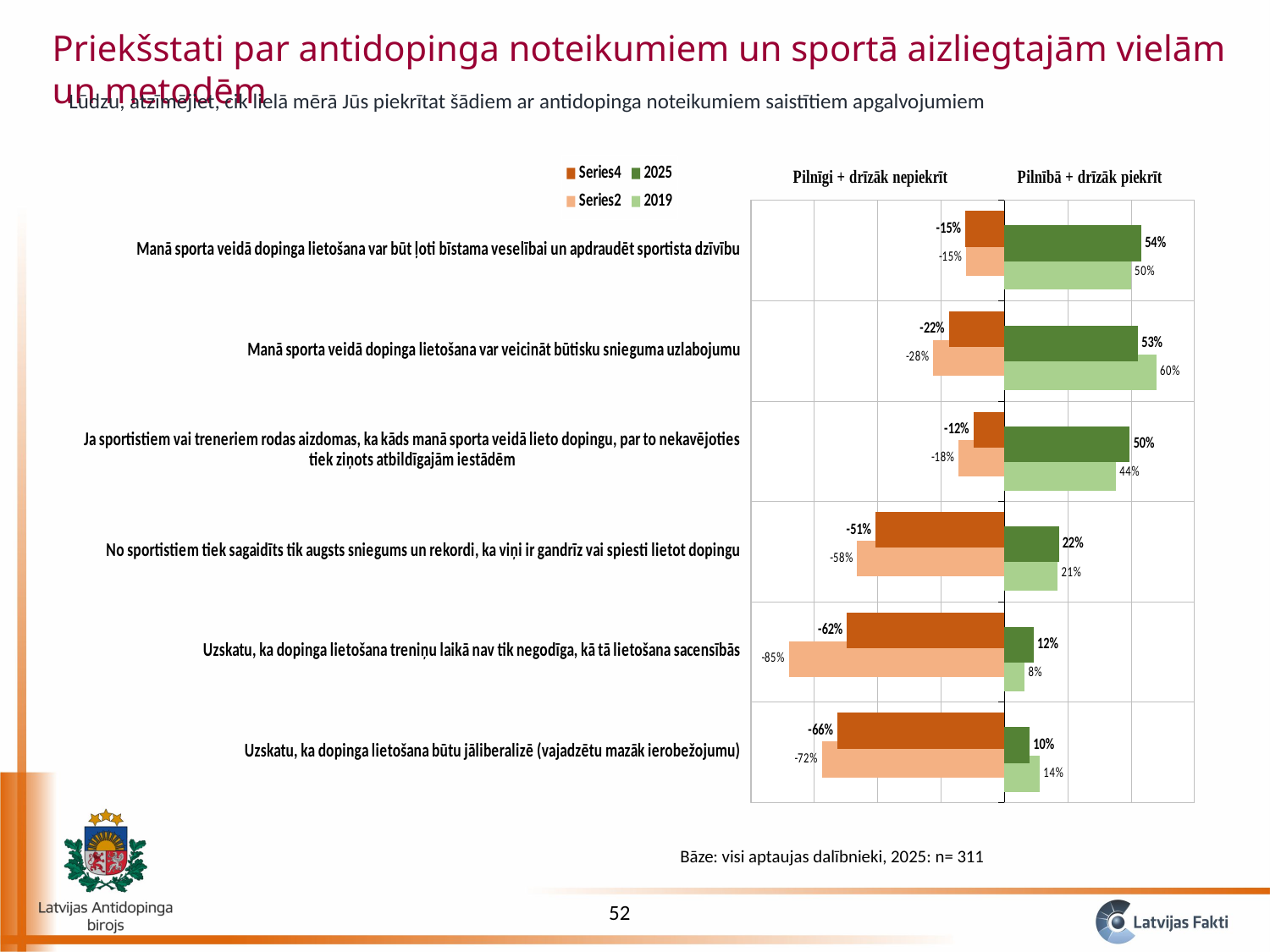
What kind of chart is shown on the slide? bar chart Which statement has the lowest 2025 agreement value? Uzskatu, ka dopinga lietošana būtu jāliberalizē (vajadzētu mazāk ierobežojumu) What is the heading shown above the right-hand (agreement) side of the chart? Pilnībā + drīzāk piekrīt What is the 2025 agreement value (Pilnībā + drīzāk piekrīt) for the statement "Manā sporta veidā dopinga lietošana var būt ļoti bīstama veselībai un apdraudēt sportista dzīvību"? 54% What is the 2025 agreement value for the statement "No sportistiem tiek sagaidīts tik augsts sniegums un rekordi, ka viņi ir gandrīz vai spiesti lietot dopingu"? 22% How many statements (categories) are plotted in the chart? 6 What is the 2019 disagreement value (Pilnīgi + drīzāk nepiekrīt) for the statement "Uzskatu, ka dopinga lietošana treniņu laikā nav tik negodīga, kā tā lietošana sacensībās"? -85% How many series does the chart legend list? 4 What is the difference between the 2019 and 2025 agreement values for the statement "Manā sporta veidā dopinga lietošana var veicināt būtisku snieguma uzlabojumu"? 7 percentage points Which statement has the highest 2025 agreement value? Manā sporta veidā dopinga lietošana var būt ļoti bīstama veselībai un apdraudēt sportista dzīvību For the statement "Ja sportistiem vai treneriem rodas aizdomas, ka kāds manā sporta veidā lieto dopingu, par to nekavējoties tiek ziņots atbildīgajām iestādēm", is the 2025 agreement value larger or smaller than the 2019 agreement value? larger What is the 2019 agreement value for the statement "Manā sporta veidā dopinga lietošana var veicināt būtisku snieguma uzlabojumu"? 60%